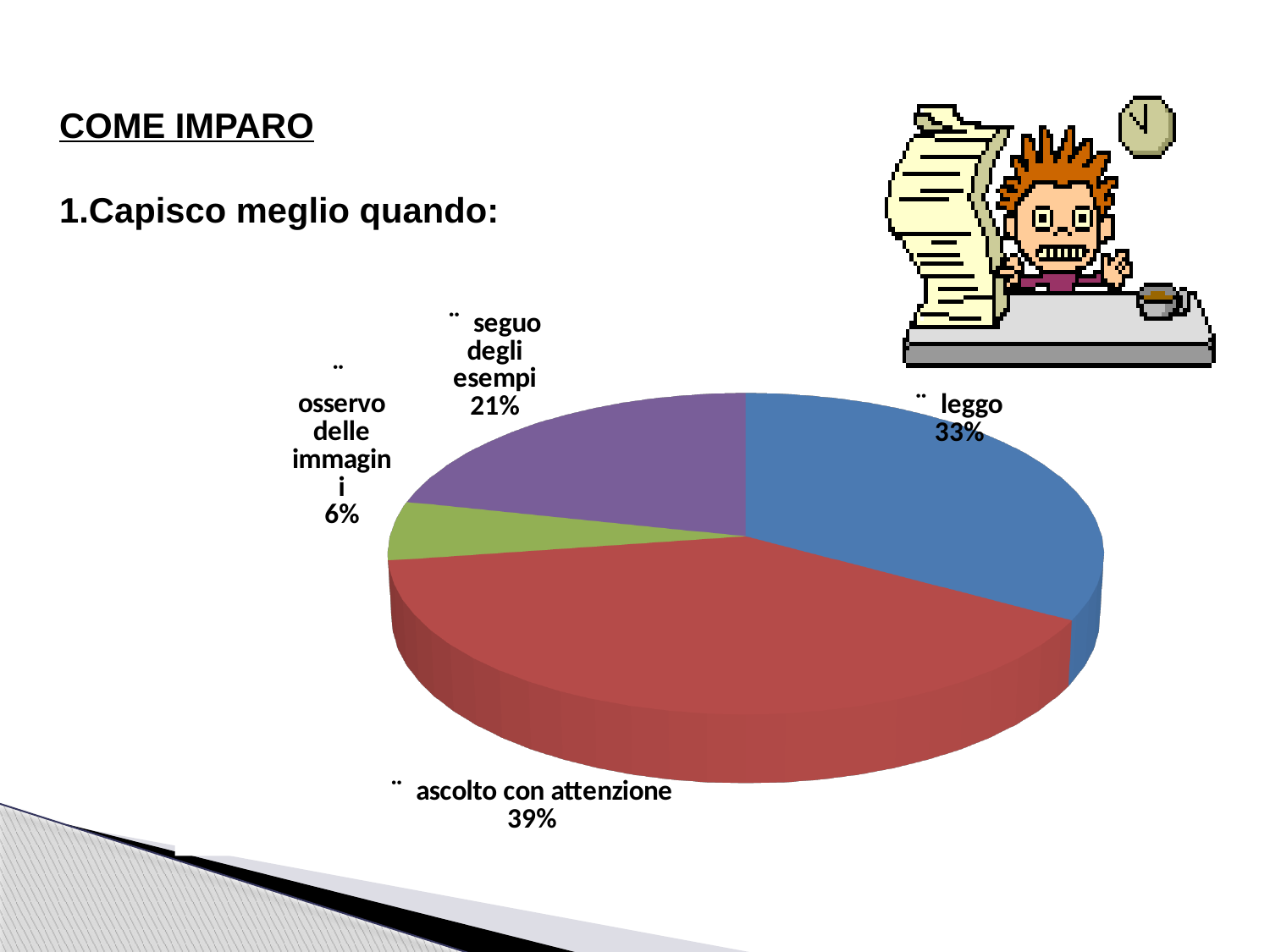
What percentage is shown for "seguo degli esempi"? 21% What percentage is shown for "osservo delle immagini"? 6% Which slice of the pie is the largest? ascolto con attenzione Which slice of the pie is the smallest? osservo delle immagini What kind of chart is shown on the slide? pie chart Which is larger, "seguo degli esempi" or "osservo delle immagini"? seguo degli esempi How many slices does the pie chart have? 4 What percentage is shown for "leggo"? 33% What is the difference in percentage points between "ascolto con attenzione" and "leggo"? 6 What percentage is shown for "ascolto con attenzione"? 39% What colour is the slice for "seguo degli esempi"? purple What colour is the slice for "leggo"? blue